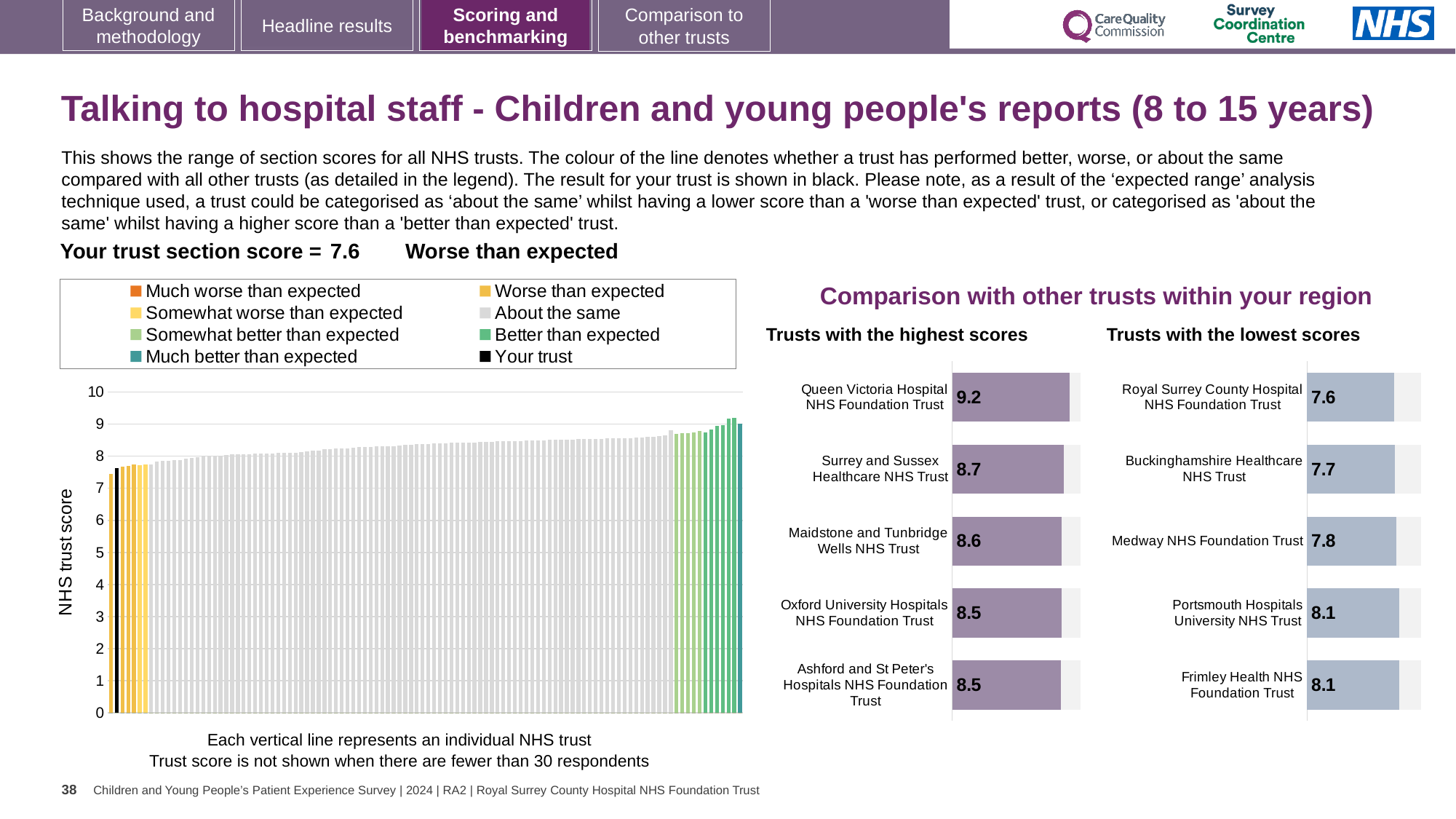
In the large chart on the left, is the value for the black 'Your trust' bar greater or less than 8? less What kind of chart is the large chart on the left of the slide? Bar chart How many trusts are shown in the 'Trusts with the lowest scores' chart? 5 In the 'Trusts with the highest scores' chart, which has the larger score: Surrey and Sussex Healthcare NHS Trust or Oxford University Hospitals NHS Foundation Trust? Surrey and Sussex Healthcare NHS Trust How many entries does the legend of the large chart on the left list? 8 In the 'Trusts with the highest scores' chart, which trust has the highest score? Queen Victoria Hospital NHS Foundation Trust In the 'Trusts with the lowest scores' chart, what is the score for Medway NHS Foundation Trust? 7.8 In the 'Trusts with the lowest scores' chart, which trust has the lowest score? Royal Surrey County Hospital NHS Foundation Trust In the large chart on the left, do the trust scores rise or fall from left to right? Rise In the 'Trusts with the highest scores' chart, what is the score for Queen Victoria Hospital NHS Foundation Trust? 9.2 What is the y-axis label of the large chart on the left? NHS trust score What is the difference between the score for Queen Victoria Hospital NHS Foundation Trust in the 'Trusts with the highest scores' chart and the score for Royal Surrey County Hospital NHS Foundation Trust in the 'Trusts with the lowest scores' chart? 1.6